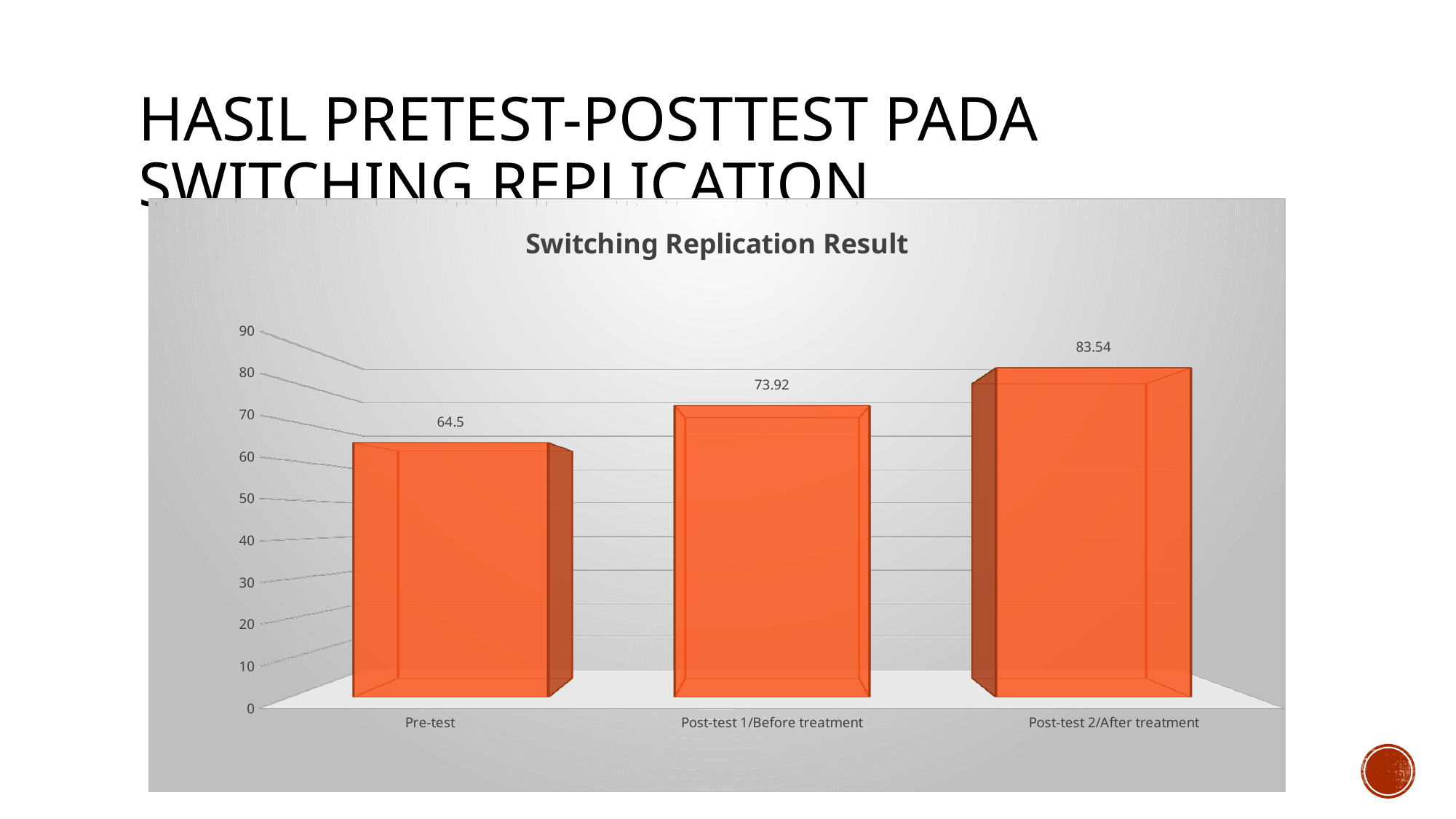
What is the title of the chart? Switching Replication Result What is the difference between the Post-test 1/Before treatment value and the Pre-test value? 9.42 What kind of chart is shown on the slide? bar chart What is the value for Post-test 1/Before treatment? 73.92 Which category has the highest value? Post-test 2/After treatment How many categories are shown on the x axis? 3 Which category has the lowest value? Pre-test Is the value for Pre-test greater or less than 70? less What is the difference between the Post-test 2/After treatment value and the Pre-test value? 19.04 Which is larger, the value for Post-test 1/Before treatment or the value for Post-test 2/After treatment? Post-test 2/After treatment What is the value for Post-test 2/After treatment? 83.54 What is the value for Pre-test? 64.5